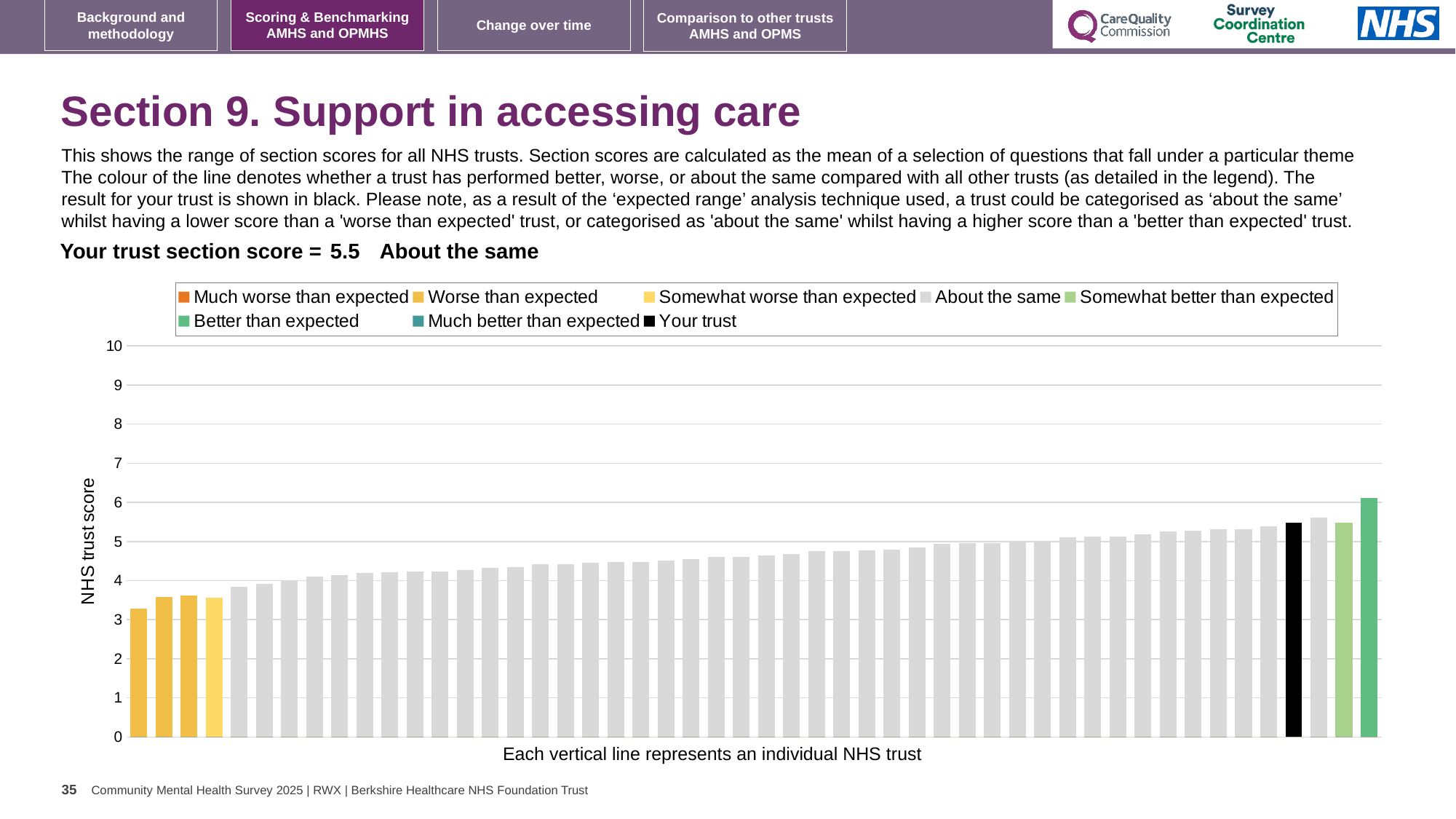
How many entries does the chart legend list? 8 Do the bar values rise or fall from left to right along the x axis? rise What is the section score for your trust shown on the slide? 5.5 What is the label on the vertical axis of the chart? NHS trust score Is the bar for your trust higher or lower than the leftmost bar? higher Is the value for your trust (black bar) greater or less than 6? less Which category is your trust placed in for this section? About the same Is the value for your trust (black bar) greater or less than 5? greater What kind of chart is shown on the slide? bar chart Which legend category does the highest bar belong to? Better than expected Is the value of the leftmost bar greater or less than 4? less